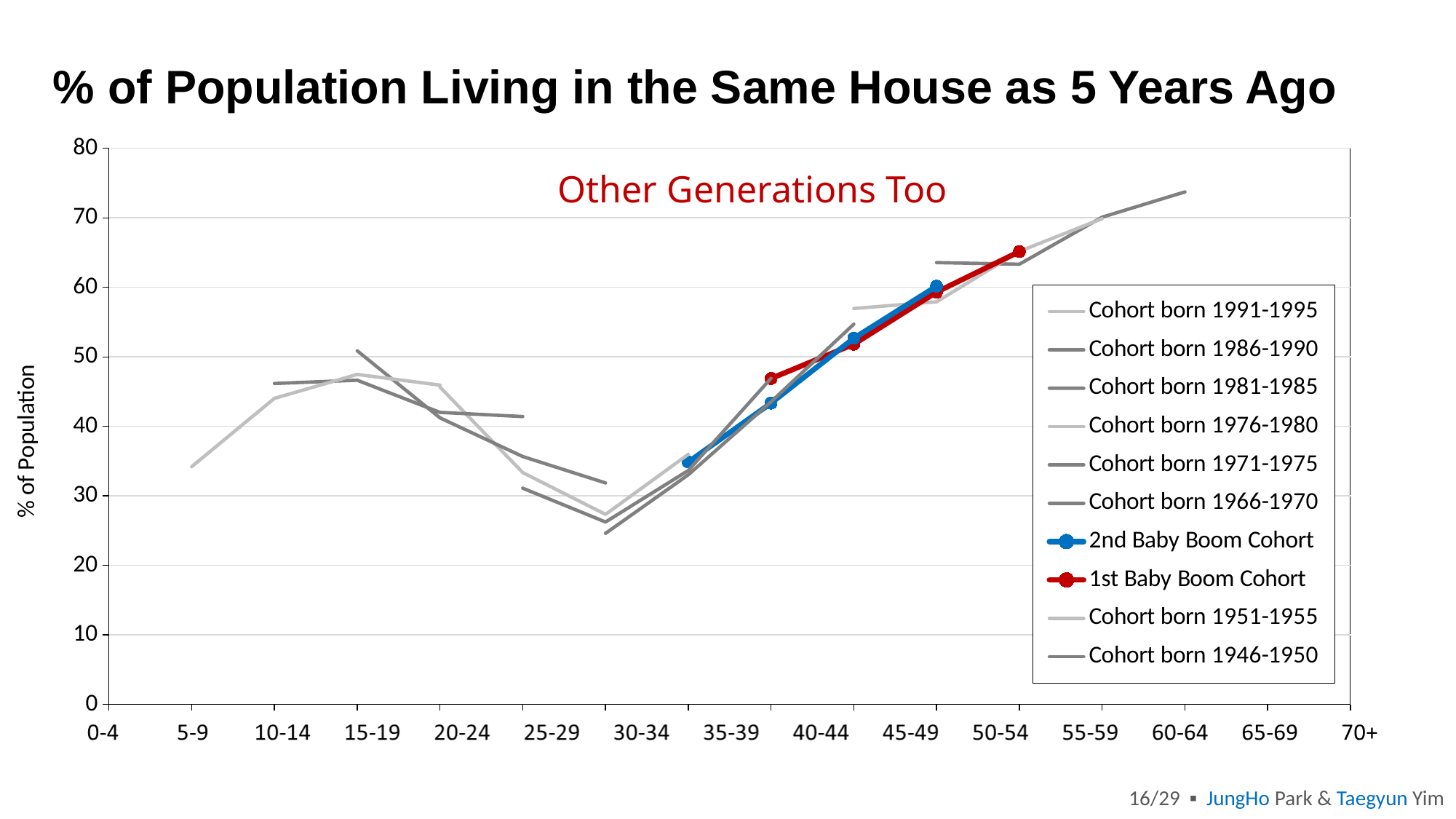
How many age-group categories are shown on the x axis? 15 What is the title of the chart? % of Population Living in the Same House as 5 Years Ago Is the lowest value of the 2nd Baby Boom Cohort line greater or less than 40? less What colour is the line for the 1st Baby Boom Cohort? red Which line reaches a higher maximum value, the 1st Baby Boom Cohort or the 2nd Baby Boom Cohort? 1st Baby Boom Cohort Does the 1st Baby Boom Cohort line rise or fall as age increases? rises Is the lowest value of the 2nd Baby Boom Cohort line greater or less than 30? greater Does the 2nd Baby Boom Cohort line rise or fall as age increases? rises How many series does the legend list? 10 What kind of chart is shown on the slide? line chart Is the highest value of the 1st Baby Boom Cohort line greater or less than 60? greater